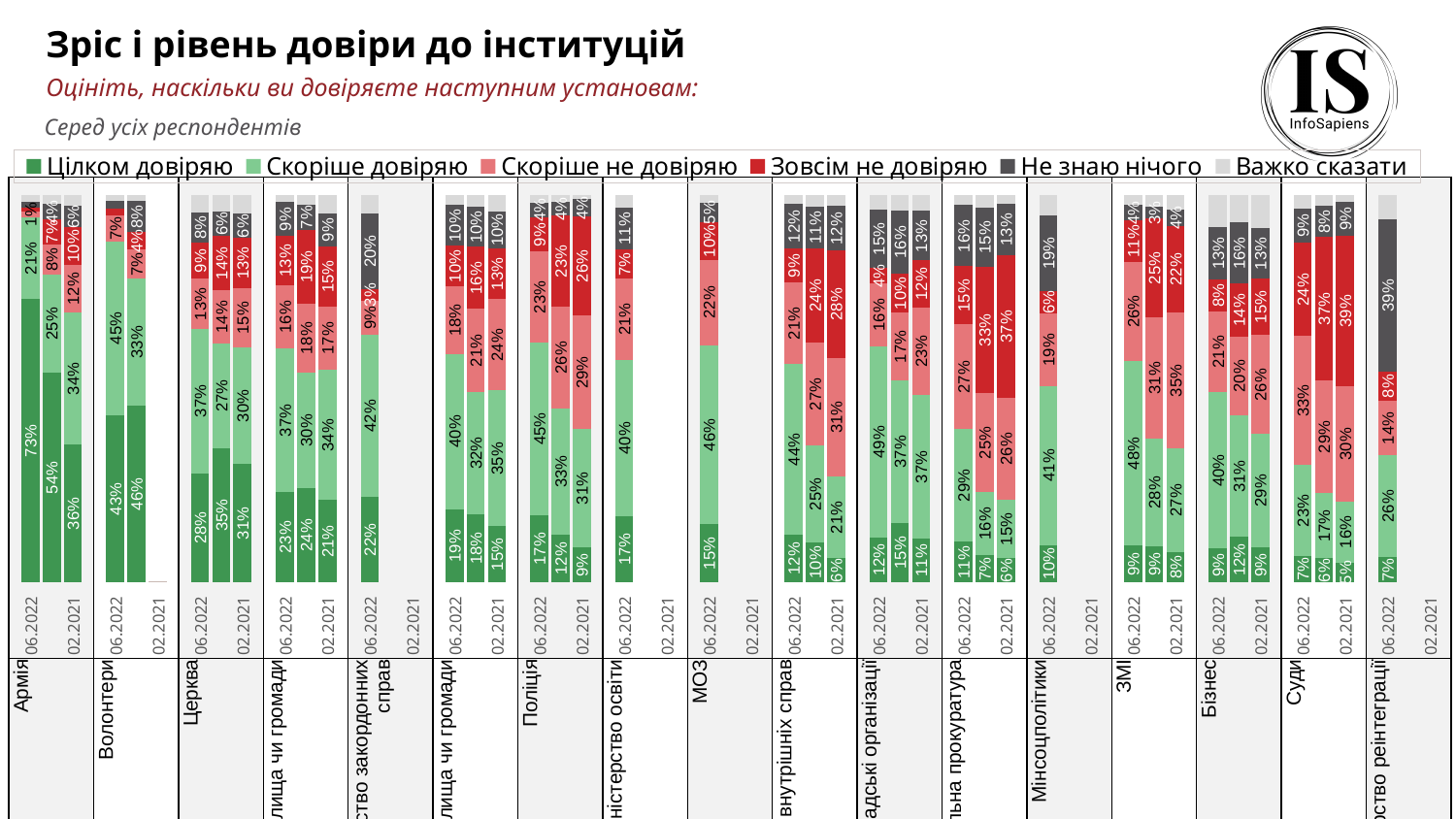
What is the 'Цілком довіряю' value for Армія in 06.2022? 73% What is the 'Цілком довіряю' value for Церква in 06.2022? 28% What is the 'Скоріше довіряю' value for Мінсоцполітики in 06.2022? 41% What is the first series listed in the legend? Цілком довіряю What kind of chart is shown on the slide? Stacked bar chart Which has the larger 'Цілком довіряю' value in 06.2022: Армія or Волонтери? Армія Which institution has the highest 'Цілком довіряю' value in 06.2022? Армія What is the 'Скоріше довіряю' value for Волонтери in 06.2022? 45% How many series does the legend list? 6 What is the difference between the 'Цілком довіряю' values for Армія in 06.2022 and 02.2021? 37 percentage points What is the 'Цілком довіряю' value for Армія in 02.2021? 36% What is the 'Скоріше не довіряю' value for Суди in 06.2022? 33%